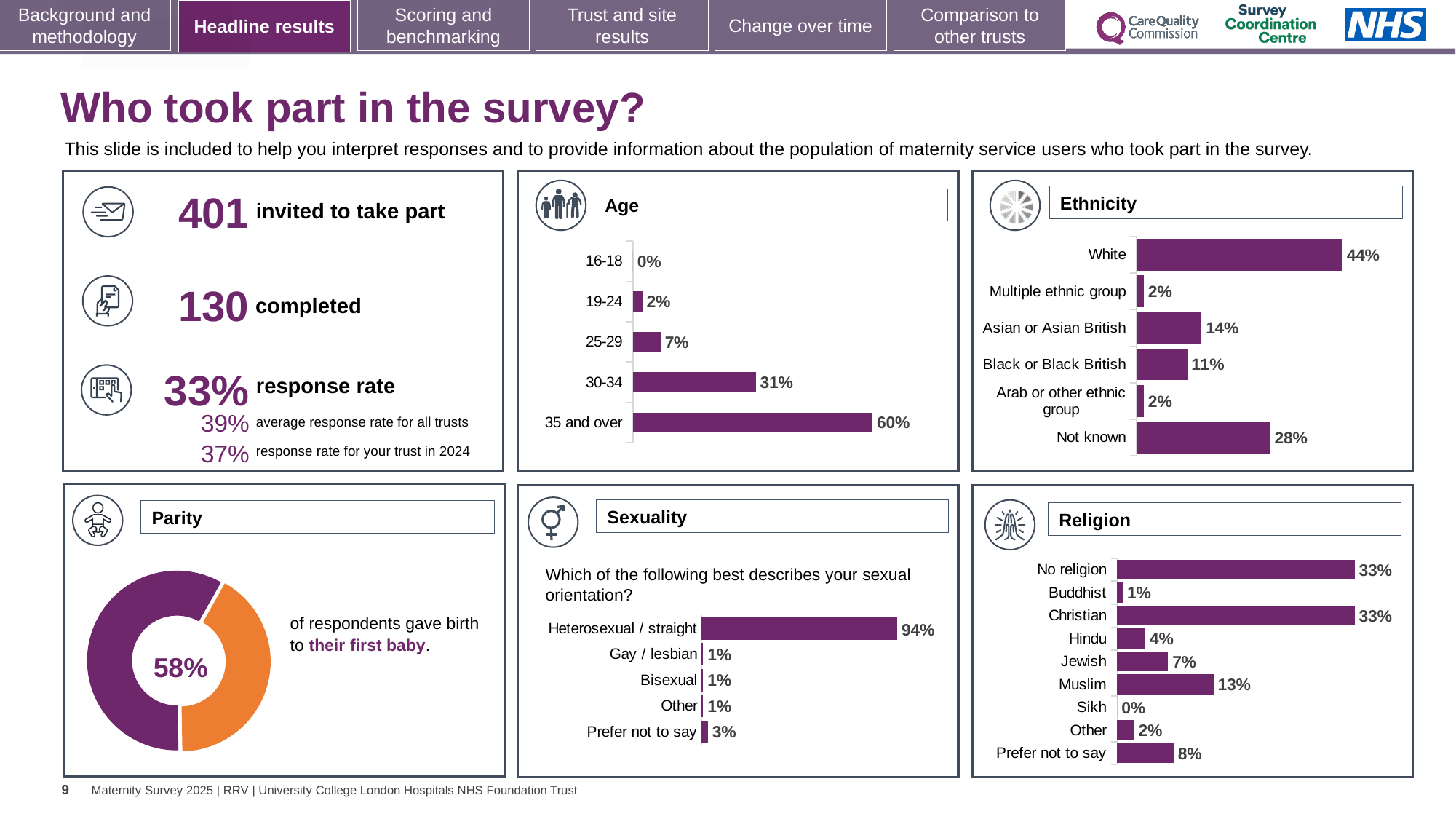
In the Age chart, what percentage of respondents were aged 35 and over? 60% In the Parity chart, what percentage of respondents gave birth to their first baby? 58% In the Ethnicity chart, which category has the highest percentage? White In the Ethnicity chart, which is larger: Black or Black British or Not known? Not known In the Ethnicity chart, how many categories are shown? 6 In the Ethnicity chart, what percentage of respondents were Asian or Asian British? 14% What kind of chart is the Parity chart? Doughnut chart In the Age chart, which age group has the highest percentage? 35 and over In the Sexuality chart, what percentage of respondents answered Prefer not to say? 3% In the Religion chart, what percentage of respondents were Muslim? 13% In the Age chart, what is the difference between the 35 and over group and the 30-34 group? 29% In the Religion chart, what is the difference between Prefer not to say and Jewish? 1%